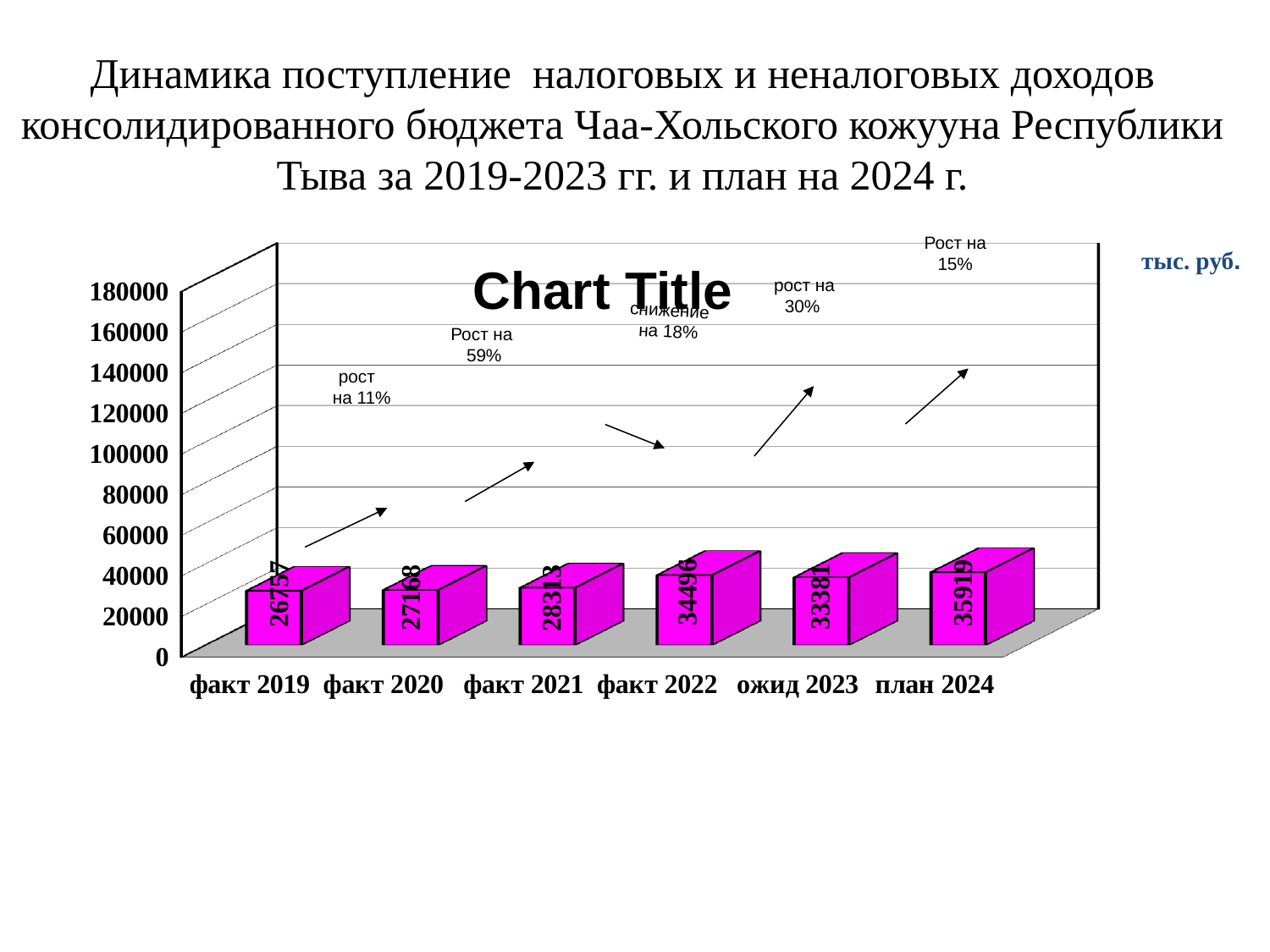
What is the value for факт 2022? 34496 Which is larger, the value for факт 2022 or the value for ожид 2023? факт 2022 What kind of chart is shown on the slide? bar chart What is the difference between the values for факт 2022 and ожид 2023? 1115 Which category has the highest value? план 2024 How many categories are shown on the x axis? 6 What unit label is shown at the top right of the chart? тыс. руб. What is the value for план 2024? 35919 What is the value for ожид 2023? 33381 What is the difference between the values for план 2024 and факт 2022? 1423 What is the value for факт 2020? 27168 Is the value for факт 2019 greater or less than 40000? less